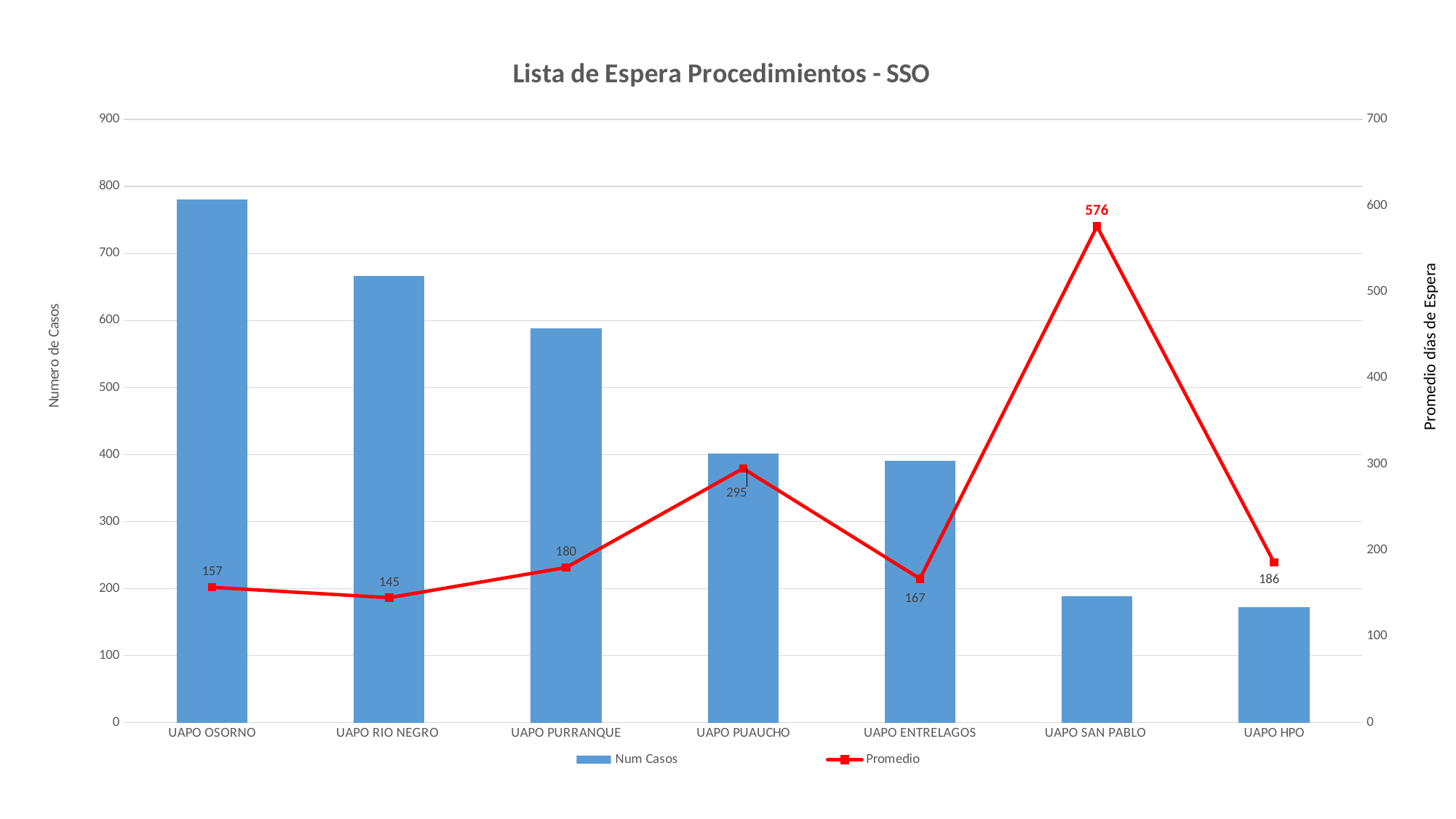
How many categories are shown on the x axis? 7 What is the difference between the Promedio values for UAPO SAN PABLO and UAPO RIO NEGRO? 431 What is the Promedio value for UAPO HPO? 186 Which category has the highest Num Casos bar? UAPO OSORNO Is the Num Casos value for UAPO SAN PABLO greater or less than 200? less What is the Promedio value for UAPO RIO NEGRO? 145 How many series does the legend list? 2 Which category has the lowest Promedio value? UAPO RIO NEGRO Which category has the highest Promedio value? UAPO SAN PABLO What is the Promedio value for UAPO SAN PABLO? 576 Is the Num Casos value for UAPO OSORNO greater or less than 700? greater Which has a larger Promedio value, UAPO PUAUCHO or UAPO PURRANQUE? UAPO PUAUCHO